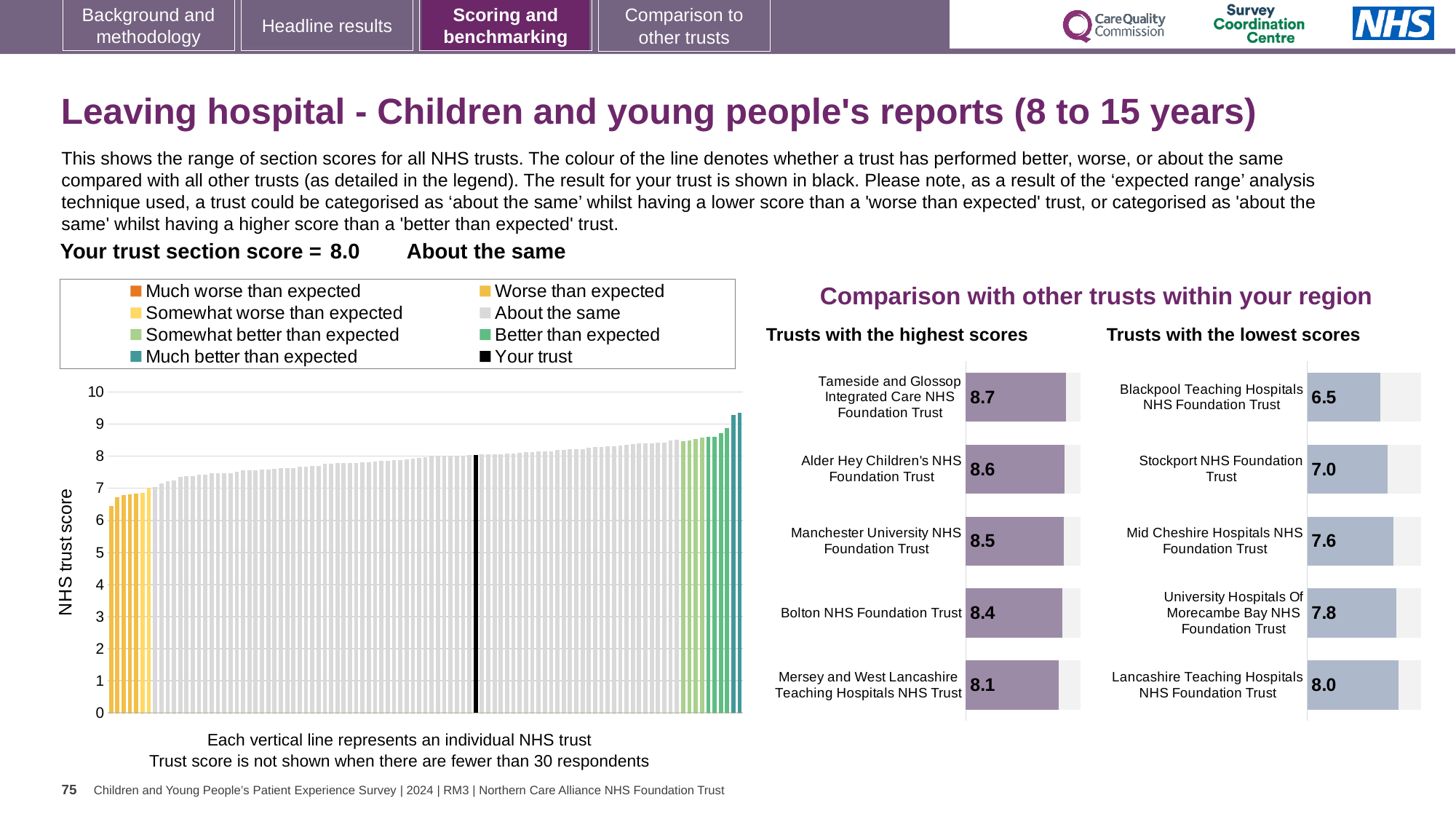
In the 'Trusts with the lowest scores' chart, what is the score for Mid Cheshire Hospitals NHS Foundation Trust? 7.6 In the 'Trusts with the highest scores' chart, what is the score for Tameside and Glossop Integrated Care NHS Foundation Trust? 8.7 In the main chart on the left showing NHS trust scores, what is the section score for your trust (the black line)? 8.0 In the 'Trusts with the highest scores' chart, which trust has the highest score? Tameside and Glossop Integrated Care NHS Foundation Trust How many entries does the legend above the main chart on the left list? 8 In the 'Trusts with the highest scores' chart, what is the score for Bolton NHS Foundation Trust? 8.4 In the 'Trusts with the lowest scores' chart, which has the larger score: Stockport NHS Foundation Trust or University Hospitals Of Morecambe Bay NHS Foundation Trust? University Hospitals Of Morecambe Bay NHS Foundation Trust In the 'Trusts with the highest scores' chart, what is the difference between the scores of Tameside and Glossop Integrated Care NHS Foundation Trust and Mersey and West Lancashire Teaching Hospitals NHS Trust? 0.6 In the 'Trusts with the lowest scores' chart, how many trusts are shown? 5 What kind of chart is the main chart on the left showing NHS trust scores? Bar chart In the 'Trusts with the lowest scores' chart, which trust has the lowest score? Blackpool Teaching Hospitals NHS Foundation Trust In the 'Trusts with the lowest scores' chart, what is the score for Blackpool Teaching Hospitals NHS Foundation Trust? 6.5